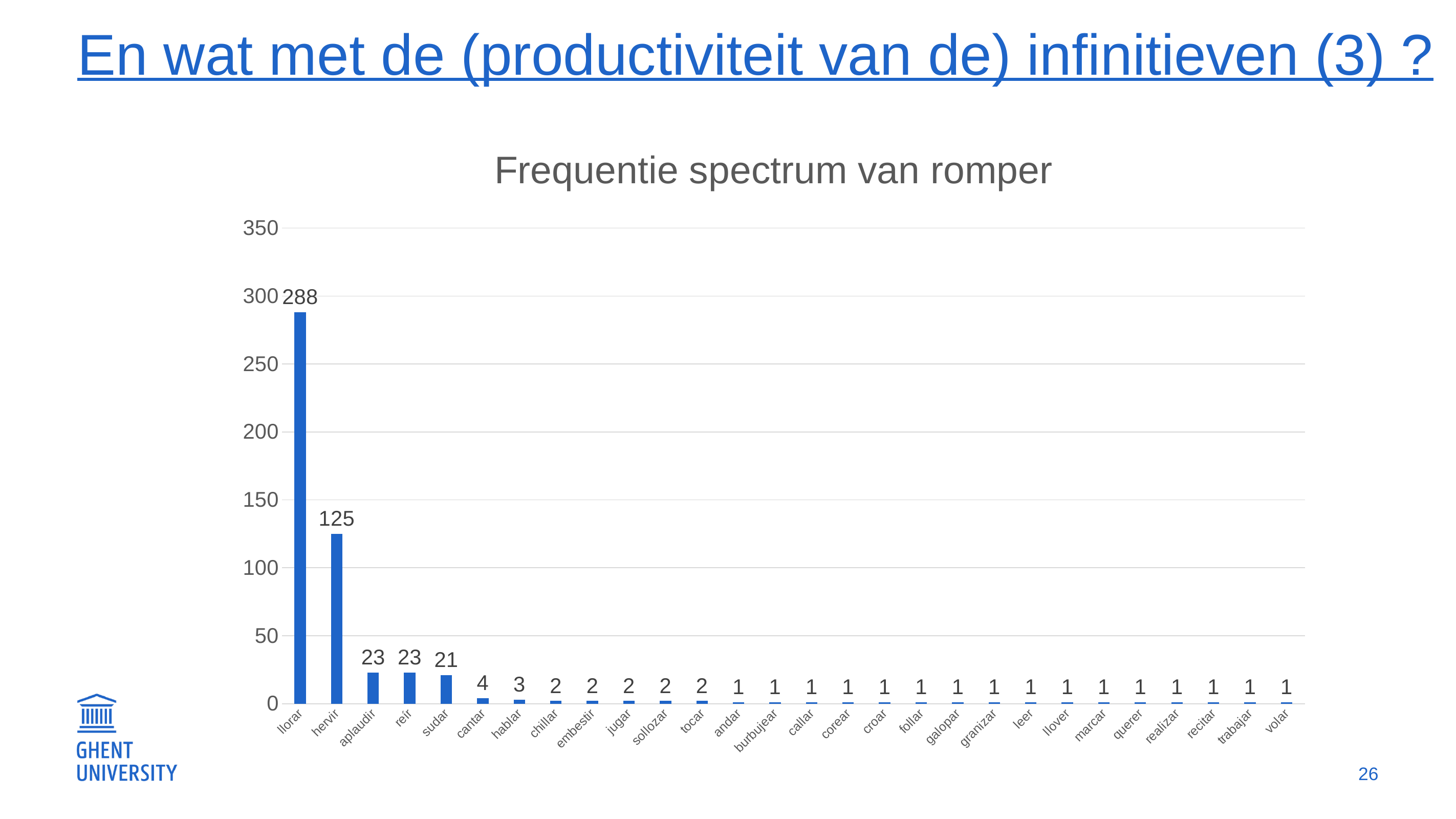
What is the title of the chart? Frequentie spectrum van romper What is the difference between the values for llorar and hervir? 163 Which is larger, the value for hervir or the value for reír? hervir What is the value for sudar? 21 What is the value for hervir? 125 What is the difference between the values for aplaudir and cantar? 19 Which category has the highest value? llorar What is the value for llorar? 288 What is the value for cantar? 4 What kind of chart is shown on the slide? bar chart How many categories are shown on the x axis? 28 Is the value for hervir greater or less than 100? greater